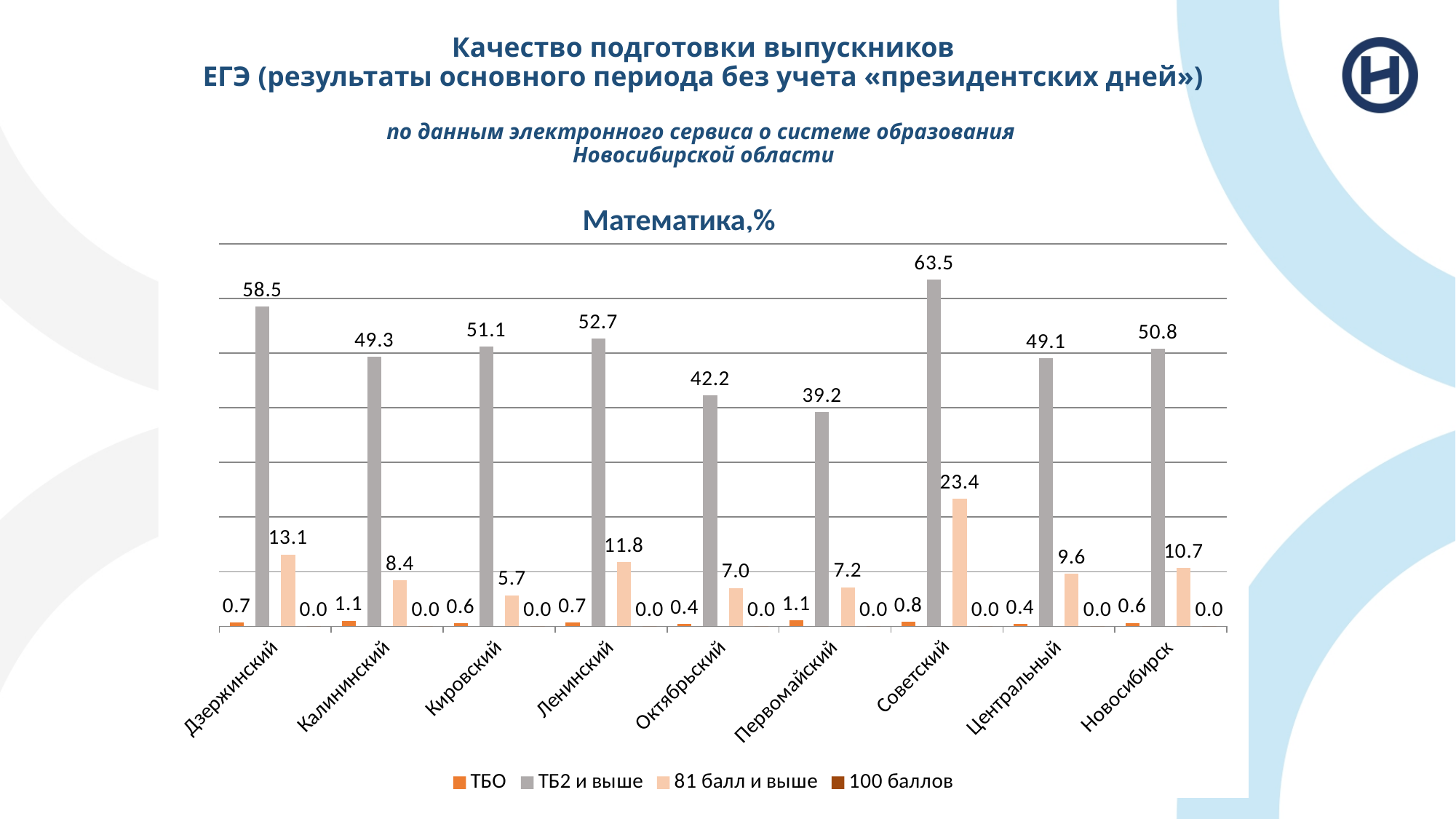
What is the value of "81 балл и выше" for Дзержинский? 13.1 What kind of chart is shown? Bar chart What is the value of "100 баллов" for Новосибирск? 0.0 How many series does the legend list? 4 What is the value of "ТБО" for Калининский? 1.1 How many categories are shown on the x axis? 9 Which is larger: the "81 балл и выше" value for Ленинский or for Новосибирск? Ленинский What is the value of "ТБ2 и выше" for Советский? 63.5 Which category has the lowest value for "ТБ2 и выше"? Первомайский Which category has the highest value for "ТБ2 и выше"? Советский Which category has the lowest value for "81 балл и выше"? Кировский What is the difference between the "ТБ2 и выше" values for Советский and Первомайский? 24.3